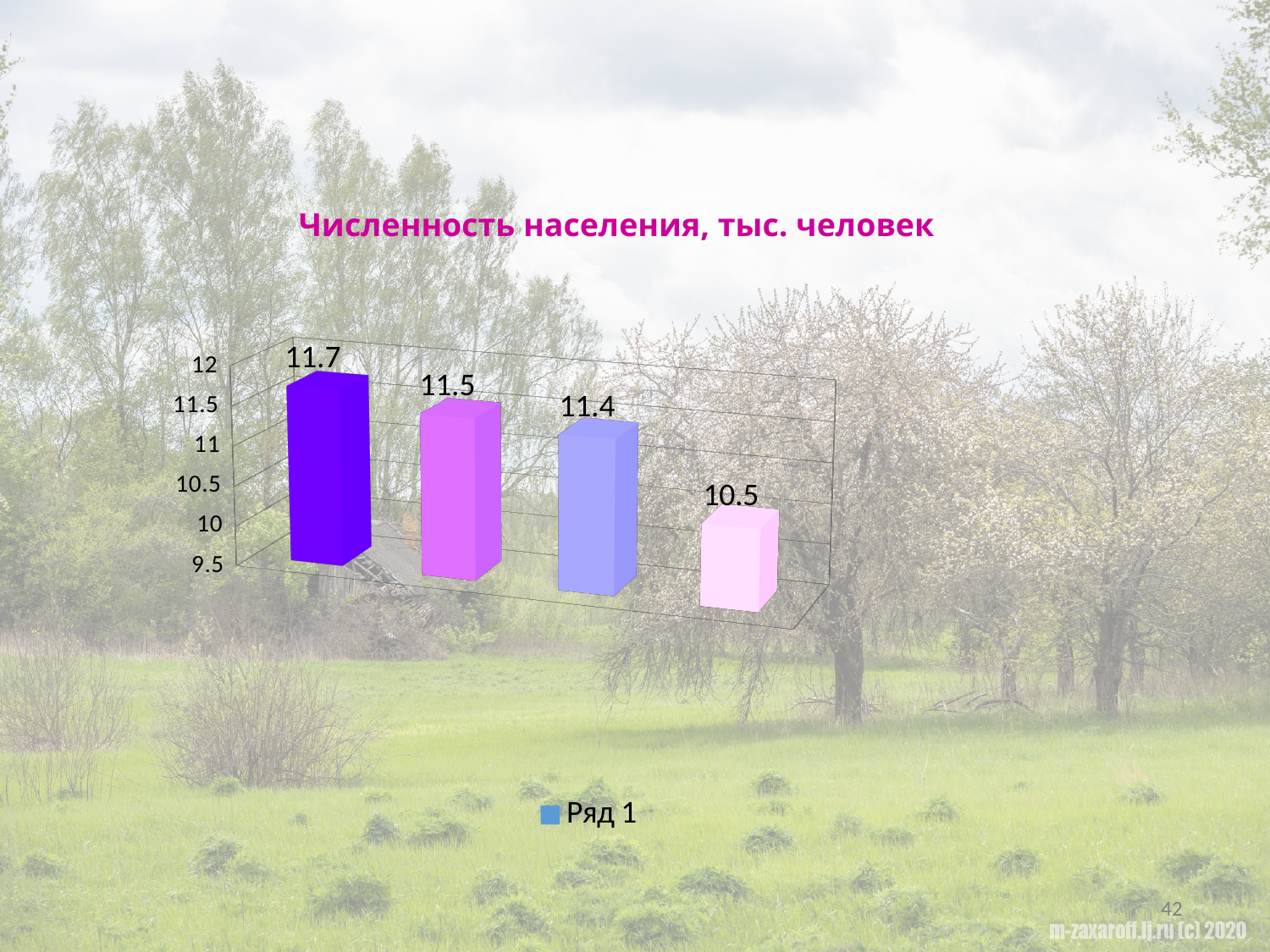
Do the values rise or fall from left to right along the x axis? fall Which bar has the lowest value? the fourth (rightmost) bar, 10.5 What is the value of the second bar from the left? 11.5 How many bars are plotted in the chart? 4 What is the value of the fourth (rightmost) bar? 10.5 What is the difference between the first bar (11.7) and the last bar (10.5)? 1.2 What is the value of the first (leftmost) bar? 11.7 What is the name of the series shown in the legend? Ряд 1 Which bar has the highest value? the first (leftmost) bar, 11.7 What is the title of the chart? Численность населения, тыс. человек How many series does the legend list? 1 What type of chart is shown on the slide? bar chart